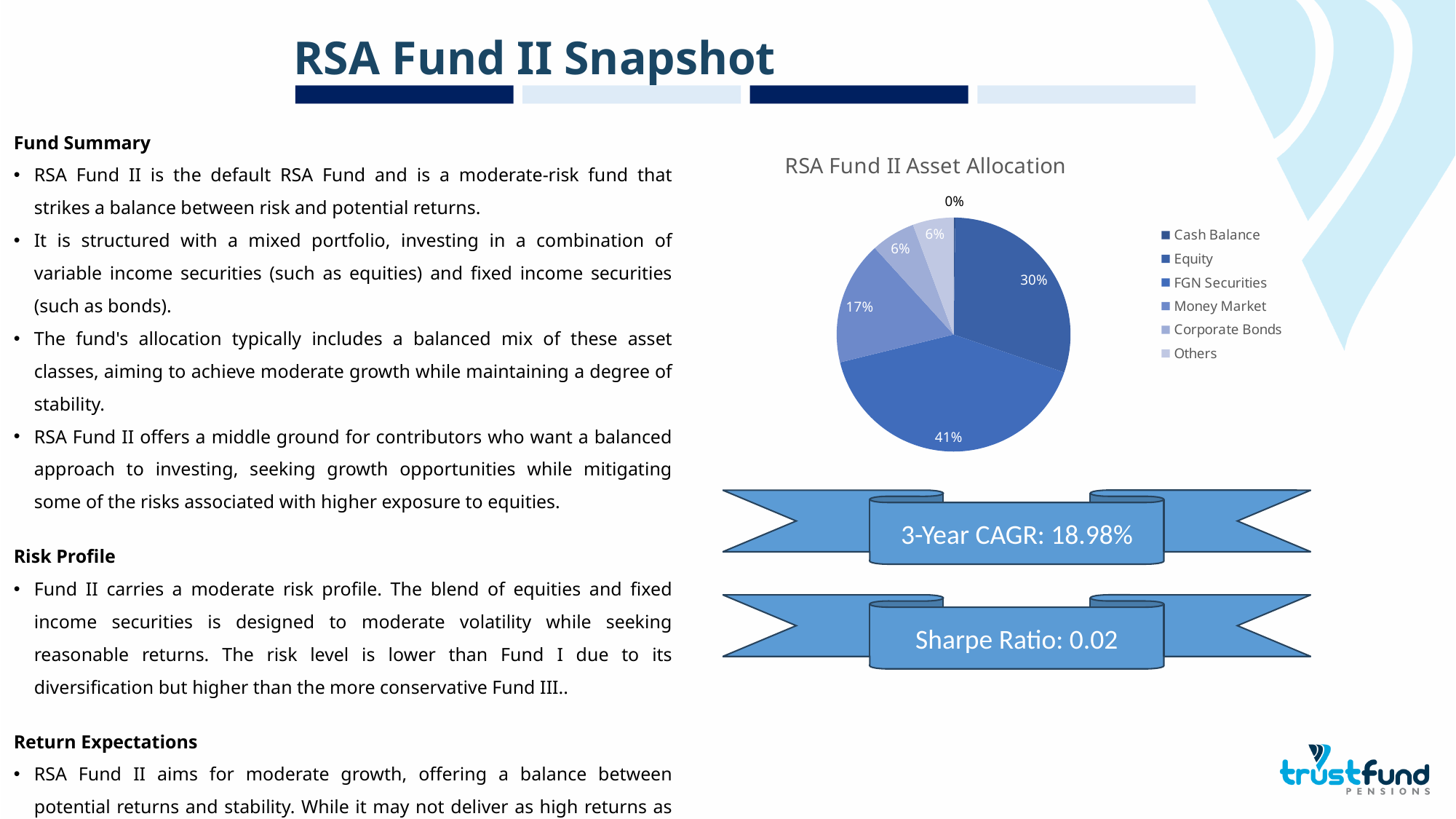
In the RSA Fund II Asset Allocation chart, what is the difference between the Equity share and the Money Market share? 13 percentage points Which asset class has the smallest share in the RSA Fund II Asset Allocation pie chart? Cash Balance What is the title of the chart on the slide? RSA Fund II Asset Allocation What percentage of the RSA Fund II Asset Allocation is Cash Balance? 0% What share of the pie does FGN Securities take in the RSA Fund II Asset Allocation chart? 41% In the RSA Fund II Asset Allocation chart, which is larger: Equity or Money Market? Equity What percentage of the RSA Fund II Asset Allocation is Money Market? 17% How many categories does the legend of the RSA Fund II Asset Allocation chart list? 6 In the RSA Fund II Asset Allocation chart, how many percentage points larger is FGN Securities than Equity? 11 percentage points What type of chart is the RSA Fund II Asset Allocation chart? pie chart What percentage of the RSA Fund II Asset Allocation is Equity? 30% Which asset class has the largest share in the RSA Fund II Asset Allocation pie chart? FGN Securities